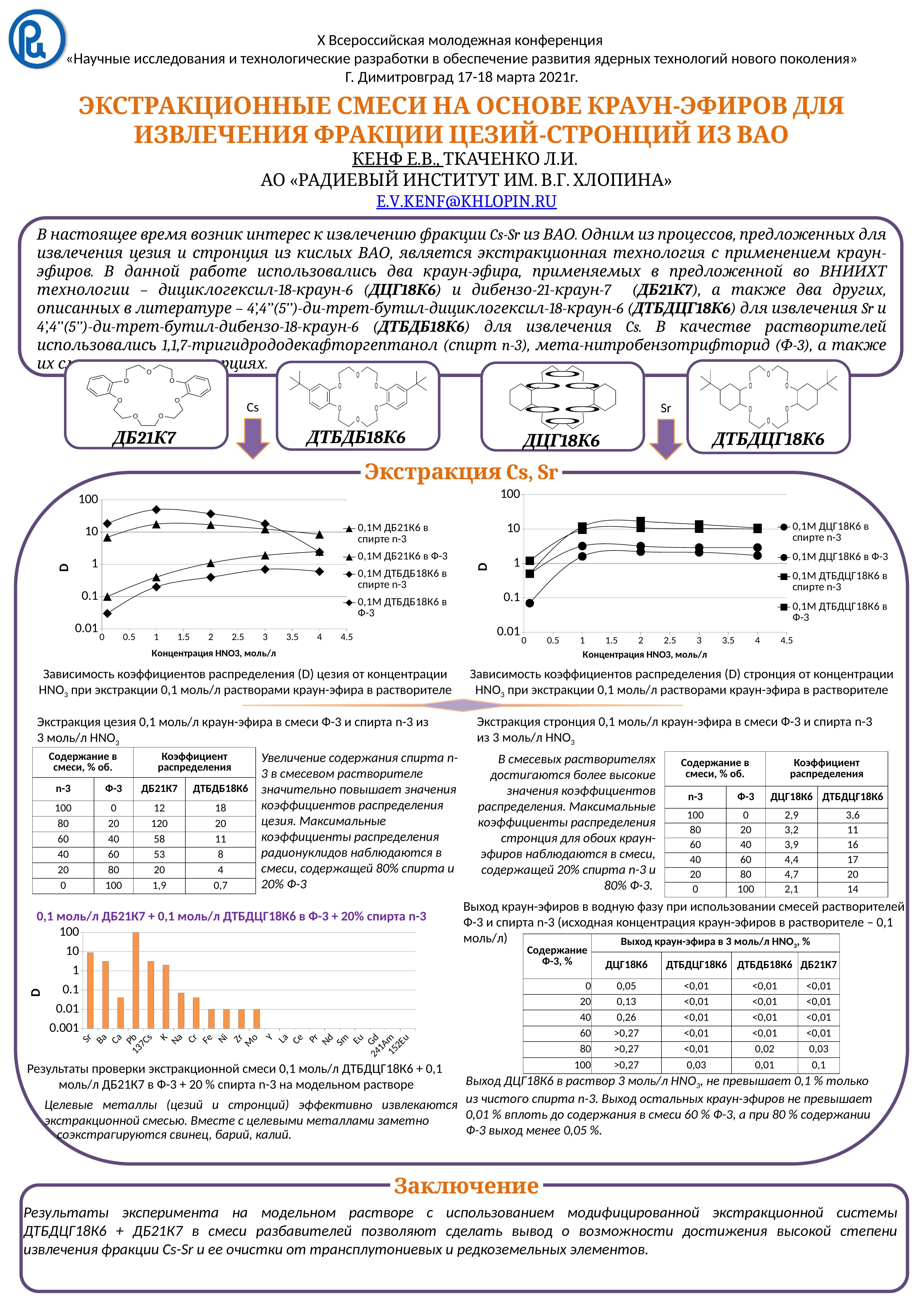
What kind of chart is the bottom-left chart titled "0,1 моль/л ДБ21К7 + 0,1 моль/л ДТБДЦГ18К6 в Ф-3 + 20% спирта n-3"? bar chart In the bottom-left bar chart, which element has the highest value of D? Pb In the bottom-left bar chart, which is larger, the value for Pb or the value for 137Cs? Pb What is the x-axis title of the left chart under "Экстракция Cs, Sr"? Концентрация HNO3, моль/л What kind of chart is the left chart under "Экстракция Cs, Sr" (cesium distribution coefficients)? line chart In the bottom-left bar chart, which is larger, the value for Sr or the value for Ba? Sr In the bottom-left bar chart, is the value for Pb greater or less than 10? greater How many series does the legend of the left chart under "Экстракция Cs, Sr" list? 4 What is the title of the bottom-left bar chart? 0,1 моль/л ДБ21К7 + 0,1 моль/л ДТБДЦГ18К6 в Ф-3 + 20% спирта n-3 In the bottom-left bar chart, is the value for Ca greater or less than 0.1? less How many categories are shown on the x axis of the bottom-left bar chart? 22 How many series does the legend of the right chart under "Экстракция Cs, Sr" list? 4